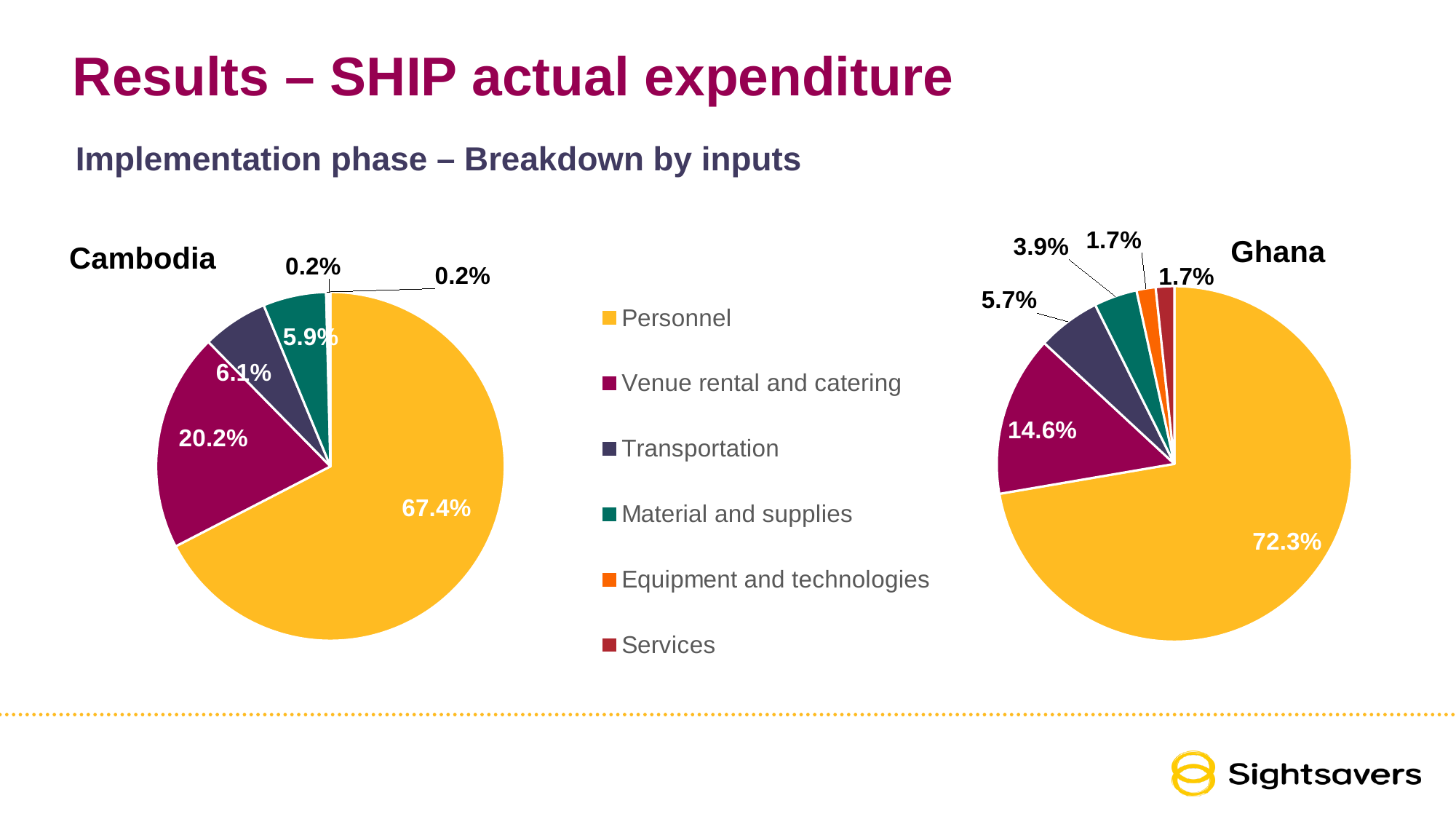
In the Cambodia pie chart, which input category has the second-largest share? Venue rental and catering In the Cambodia pie chart, what share of expenditure is Transportation? 6.1% In the Ghana pie chart, which input category has the largest share? Personnel In the Cambodia pie chart, what share of expenditure is Personnel? 67.4% What is the difference between the Personnel share in Ghana and the Personnel share in Cambodia? 4.9% How many input categories does the legend list? 6 Which colour represents Equipment and technologies in the legend? Orange What type of chart is used to show the Cambodia and Ghana breakdowns? Pie chart In the Cambodia pie chart, is the Transportation share larger or smaller than the Material and supplies share? larger